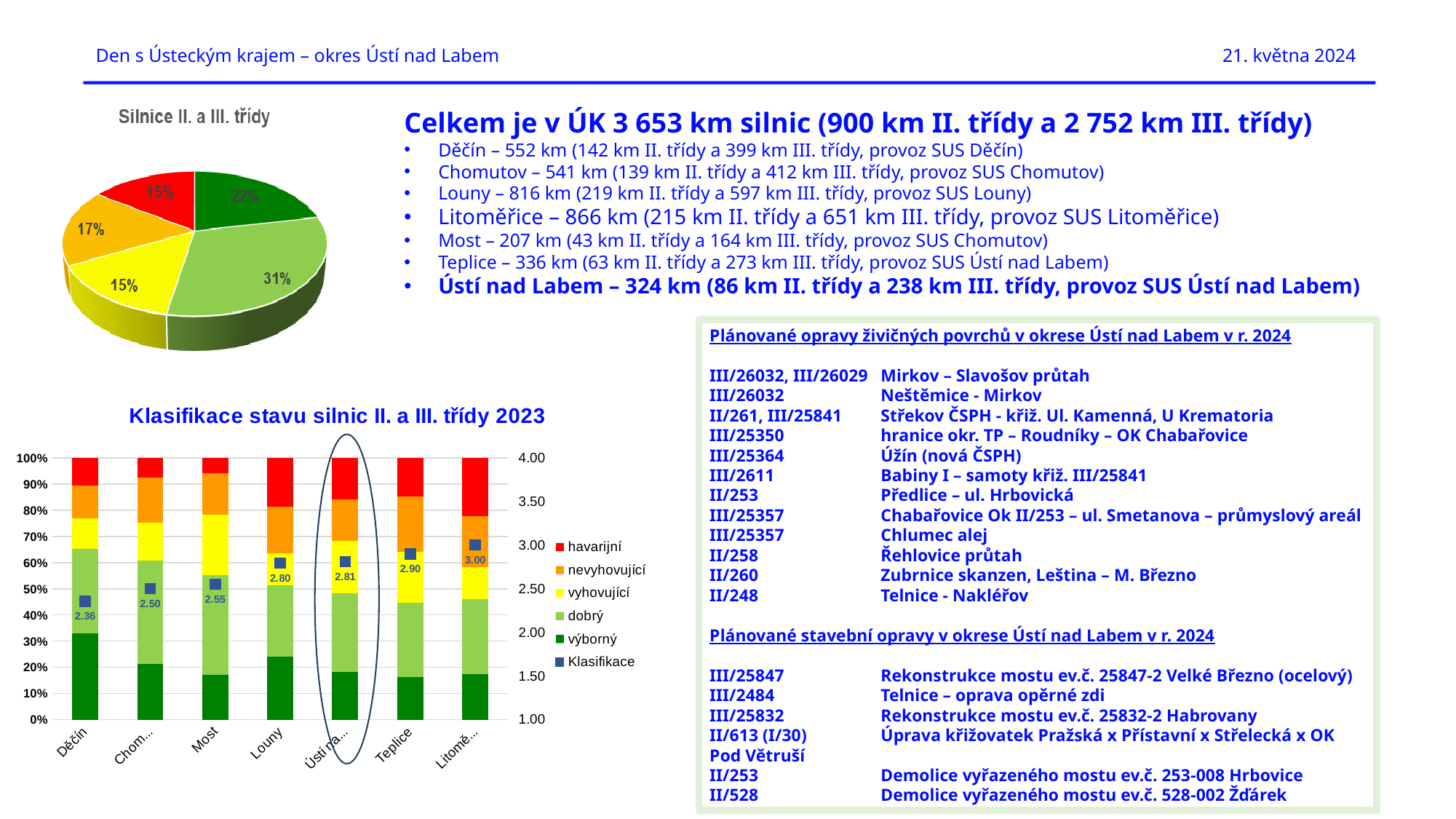
How many slices does the pie chart 'Silnice II. a III. třídy' have? 5 On the chart 'Klasifikace stavu silnic II. a III. třídy 2023', how many categories are shown on the x axis? 7 On the chart 'Klasifikace stavu silnic II. a III. třídy 2023', which category has the lowest Klasifikace value? Děčín On the chart 'Klasifikace stavu silnic II. a III. třídy 2023', what is the Klasifikace value for Louny? 2.80 On the chart 'Klasifikace stavu silnic II. a III. třídy 2023', what is the Klasifikace value for Teplice? 2.90 On the chart 'Klasifikace stavu silnic II. a III. třídy 2023', do the Klasifikace values rise or fall from left to right along the x axis? rise On the chart 'Klasifikace stavu silnic II. a III. třídy 2023', which has the higher Klasifikace value, Louny or Most? Louny On the chart 'Klasifikace stavu silnic II. a III. třídy 2023', what is the difference between the Klasifikace values for Teplice and Děčín? 0.54 On the chart 'Klasifikace stavu silnic II. a III. třídy 2023', is the 'výborný' share for Most greater or less than 20%? less What is the share of the largest slice in the pie chart 'Silnice II. a III. třídy'? 31% On the chart 'Klasifikace stavu silnic II. a III. třídy 2023', how many entries does the legend list? 6 On the chart 'Klasifikace stavu silnic II. a III. třídy 2023', what is the Klasifikace value for Děčín? 2.36